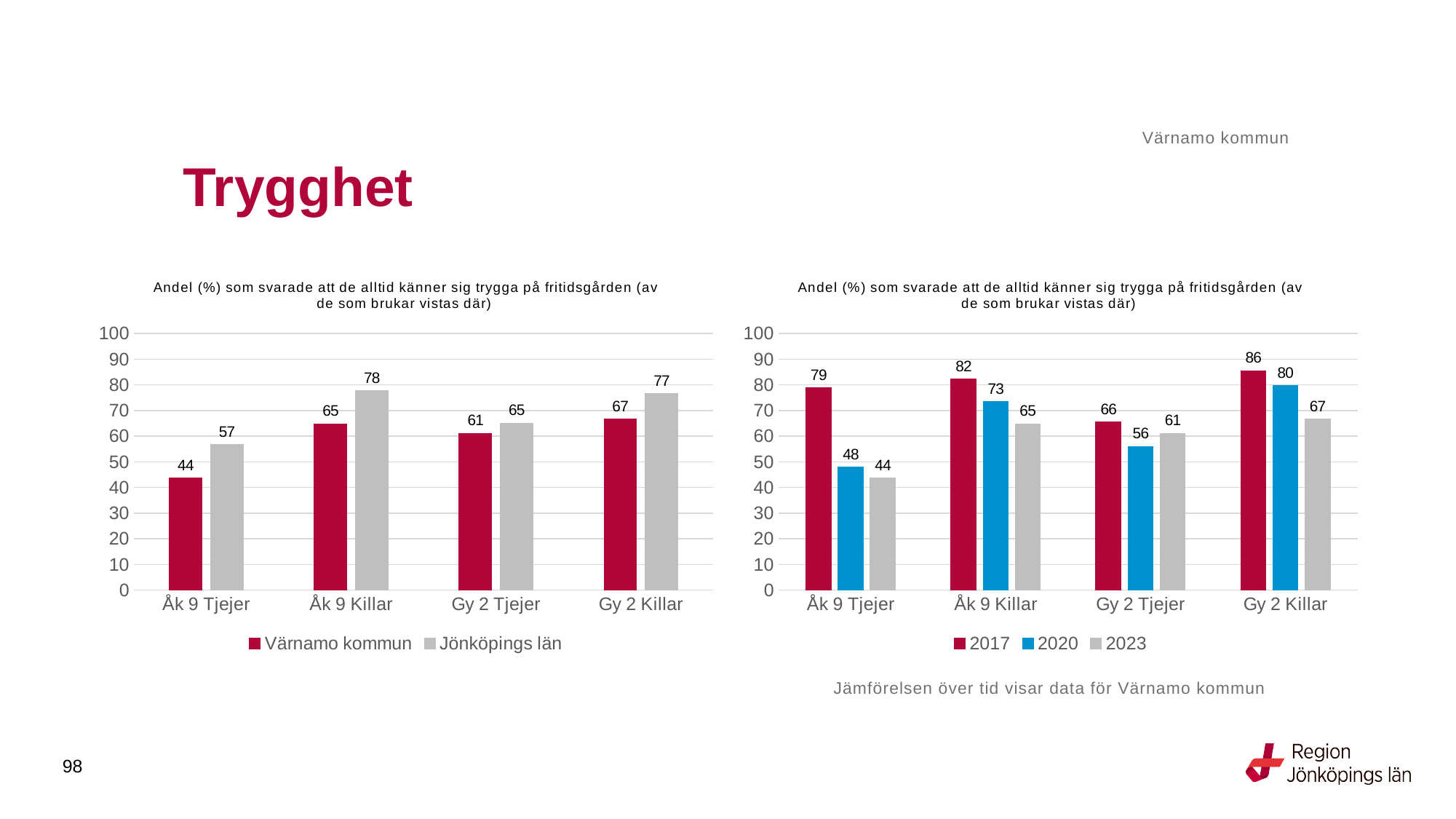
In the left chart, which category has the lowest value for Värnamo kommun? Åk 9 Tjejer In the right chart, do the values for Åk 9 Tjejer rise or fall from 2017 to 2023? fall In the right chart, what is the difference between the 2017 and 2023 values for Åk 9 Tjejer? 35 In the right chart, which category has the highest value for 2017? Gy 2 Killar What type of chart is the left chart? bar chart In the left chart, how many series does the legend list? 2 In the right chart, what is the value for 2020 for Gy 2 Tjejer? 56 In the right chart, which is larger for Åk 9 Killar: the 2017 value or the 2023 value? 2017 In the left chart, what is the value for Jönköpings län for Åk 9 Killar? 78 In the right chart, how many categories are shown on the x axis? 4 In the left chart, what is the difference between Jönköpings län and Värnamo kommun for Gy 2 Killar? 10 In the left chart, what is the value for Värnamo kommun for Åk 9 Tjejer? 44